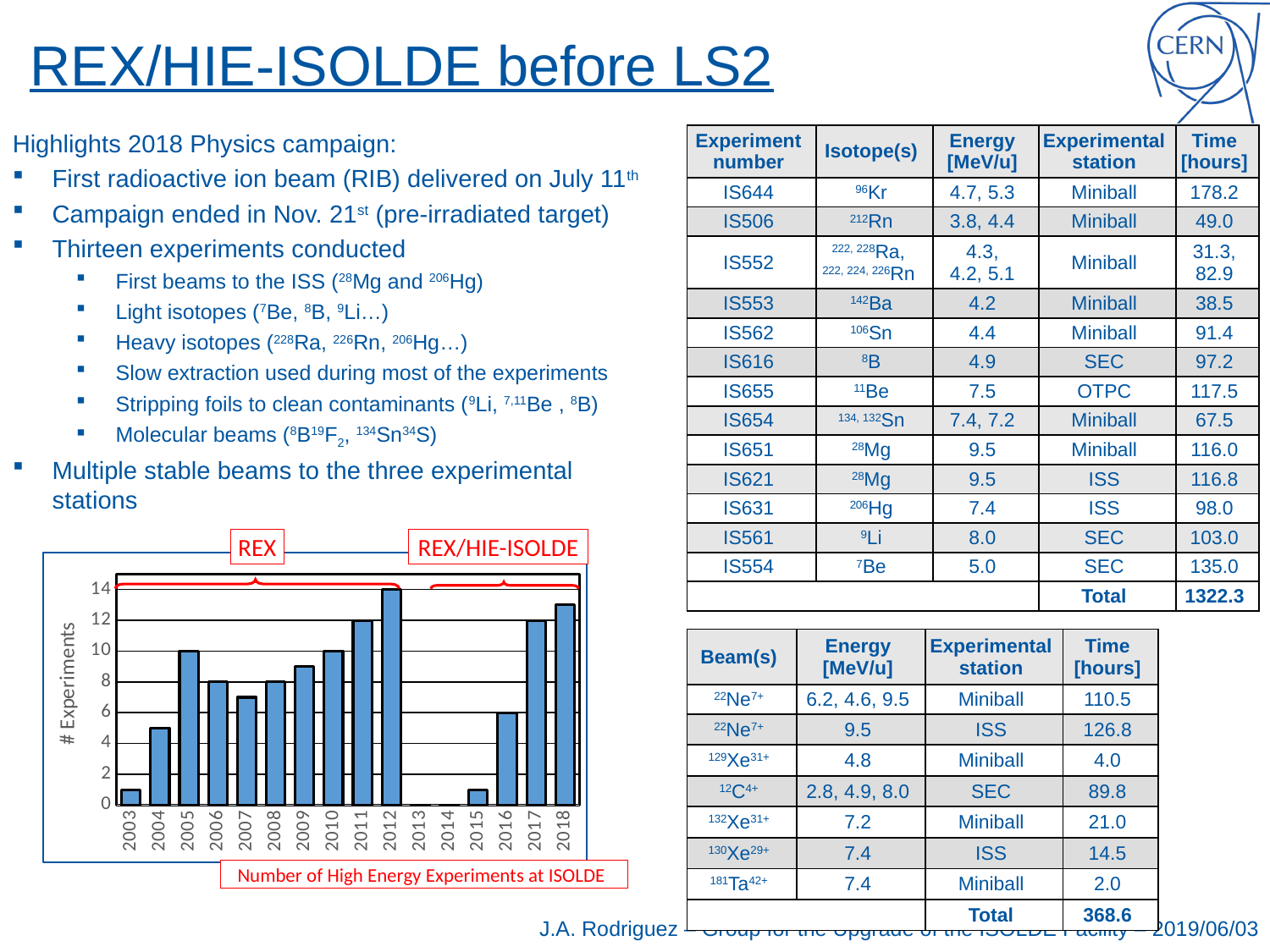
What kind of chart is shown on the slide? bar chart What is the title of the chart on the slide? Number of High Energy Experiments at ISOLDE How many experiments does the chart show for 2017? 12 How many years are shown on the x axis of the chart? 16 Does the number of experiments generally rise or fall from 2003 to 2012? rise What is the difference between the number of experiments in 2012 and in 2016? 8 Which year has the highest number of experiments in the chart? 2012 How many experiments does the chart show for 2012? 14 Is the number of experiments for 2004 greater or less than 6? less How many experiments does the chart show for 2016? 6 How many experiments does the chart show for 2005? 10 Which year has more experiments, 2005 or 2004? 2005